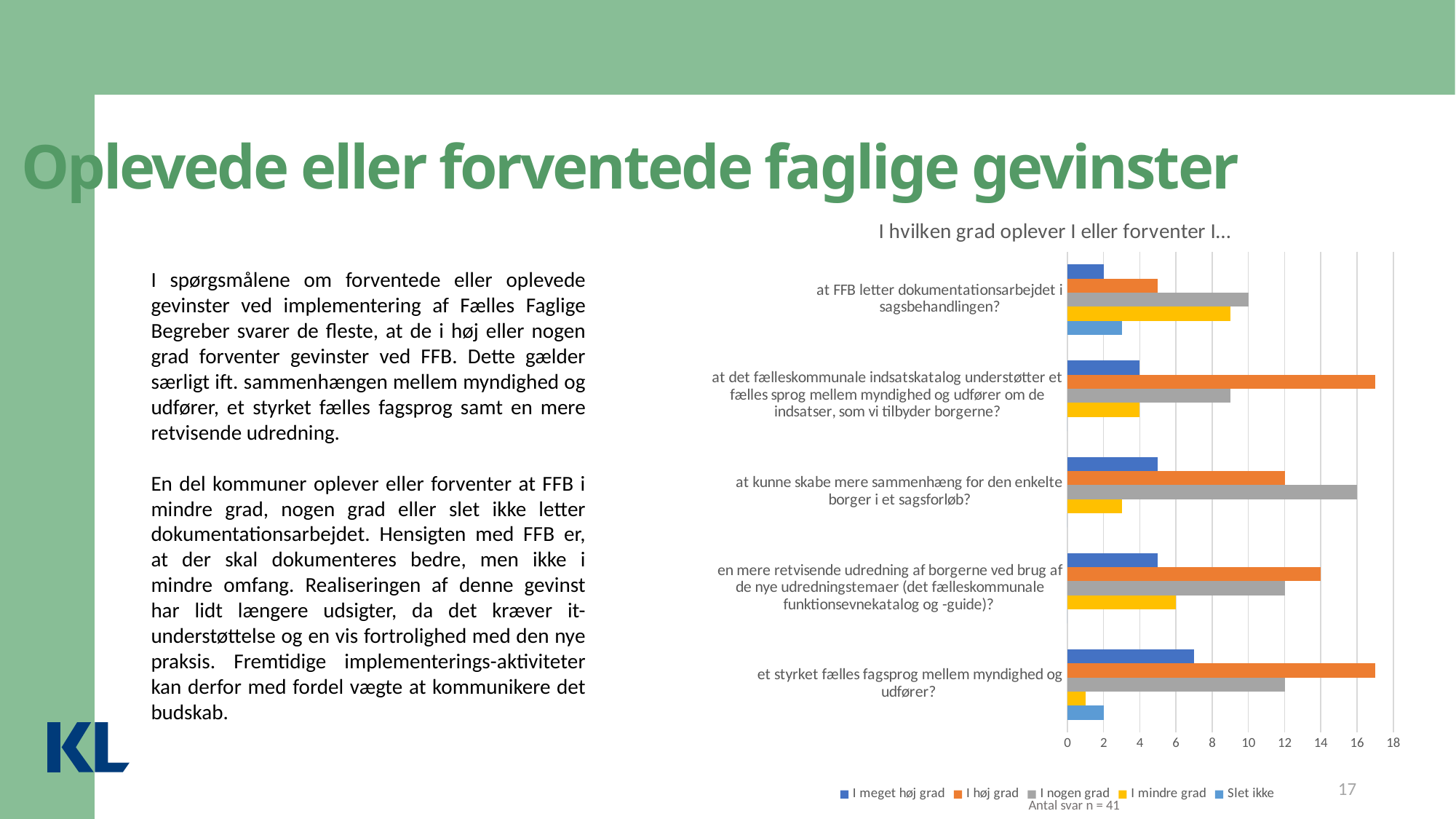
Is the value of 'I høj grad' for 'et styrket fælles fagsprog mellem myndighed og udfører?' greater or less than 16? greater What is the value of 'I nogen grad' for 'at FFB letter dokumentationsarbejdet i sagsbehandlingen?' 10 For 'at det fælleskommunale indsatskatalog understøtter et fælles sprog', which is larger: 'I høj grad' or 'I nogen grad'? I høj grad What is the title of the chart? I hvilken grad oplever I eller forventer I… What is the value of 'I høj grad' for 'en mere retvisende udredning af borgerne ved brug af de nye udredningstemaer'? 14 What is the value of 'I nogen grad' for 'at kunne skabe mere sammenhæng for den enkelte borger i et sagsforløb?' 16 How many series does the chart legend list? 5 Which series has the highest value for 'at FFB letter dokumentationsarbejdet i sagsbehandlingen?' I nogen grad What kind of chart is shown on the slide? bar chart What is the value of 'I mindre grad' for 'en mere retvisende udredning af borgerne ved brug af de nye udredningstemaer'? 6 How many question categories are plotted on the chart? 5 Is the value of 'I mindre grad' for 'et styrket fælles fagsprog mellem myndighed og udfører?' greater or less than 2? less